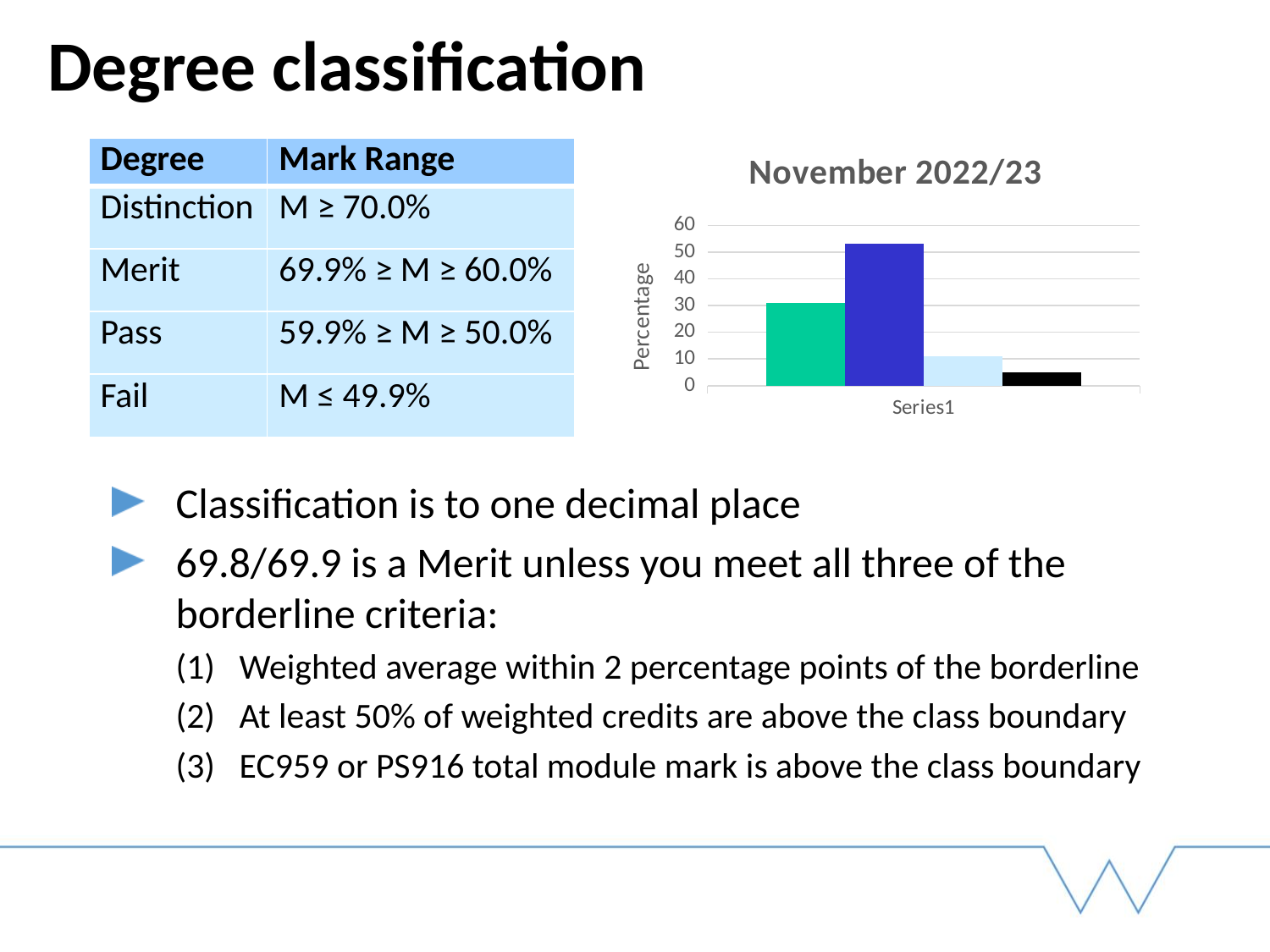
Is the value of the dark blue bar greater or less than 60? less What is the label on the vertical axis of the chart? Percentage Is the value of the green bar greater or less than 40? less Is the value of the light blue bar greater or less than 20? less What is the title of the chart? November 2022/23 How many bars are plotted in the chart? 4 Which is larger, the green bar or the light blue bar? The green bar Which bar is the shortest in the chart? The black bar (rightmost) Which bar is the tallest in the chart? The dark blue bar (second from left) What kind of chart is shown on the slide? Bar chart